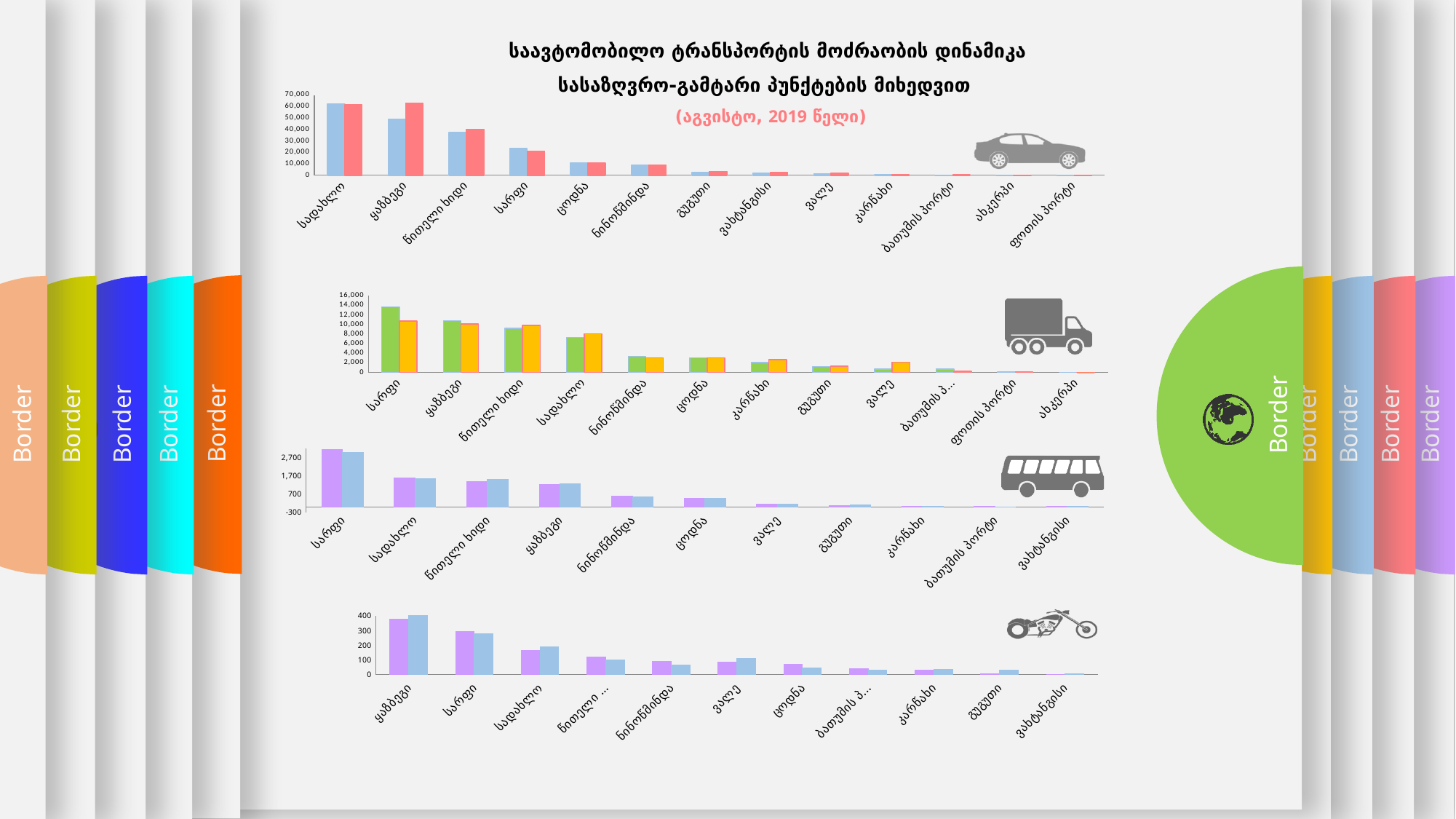
In the top chart (with the car icon), is the value of the red bar for სარფი greater or less than 30,000? less In the bottom chart (with the motorcycle icon), do the values generally rise or fall from left to right along the x axis? fall How many categories are shown on the x axis of the top chart (with the car icon)? 13 How many categories are shown on the x axis of the second chart from the top (with the truck icon)? 12 In the third chart from the top (with the bus icon), which category has the highest bars? სარფი What kind of chart is the top chart (with the car icon)? bar chart In the third chart from the top (with the bus icon), is the value of the purple bar for სარფი greater or less than 1,700? greater In the second chart from the top (with the truck icon), which category has the highest green bar? სარფი In the top chart (with the car icon), is the value of the blue bar for სადახლო greater or less than 50,000? greater In the bottom chart (with the motorcycle icon), which category has the highest bars? ყაზბეგი In the bottom chart (with the motorcycle icon), which has the larger purple bar, სარფი or სადახლო? სარფი